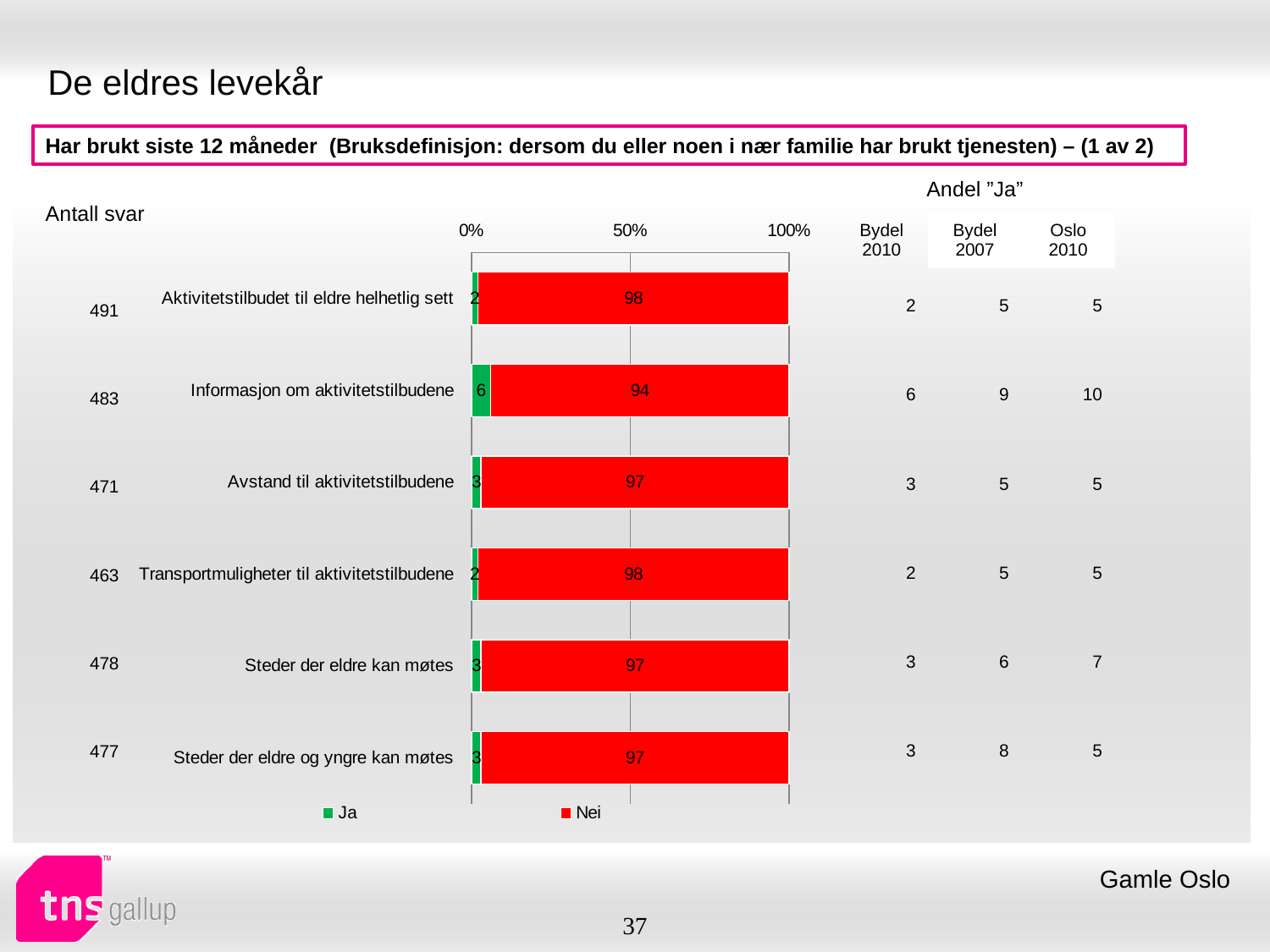
What is the "Nei" value for Aktivitetstilbudet til eldre helhetlig sett? 98 How many series does the legend list? 2 What is the difference between the "Nei" values for Aktivitetstilbudet til eldre helhetlig sett and Informasjon om aktivitetstilbudene? 4 What is the "Nei" value for Informasjon om aktivitetstilbudene? 94 What is the "Ja" value for Informasjon om aktivitetstilbudene? 6 What kind of chart is shown on the slide? Stacked bar chart What is the total of the stacked bar for Transportmuligheter til aktivitetstilbudene? 100 How many categories are shown in the bar chart? 6 Which category has the highest "Ja" value? Informasjon om aktivitetstilbudene Which category has the lowest "Nei" value? Informasjon om aktivitetstilbudene Which is larger, the "Nei" value for Avstand til aktivitetstilbudene or the "Nei" value for Informasjon om aktivitetstilbudene? Avstand til aktivitetstilbudene What is the "Nei" value for Steder der eldre kan møtes? 97